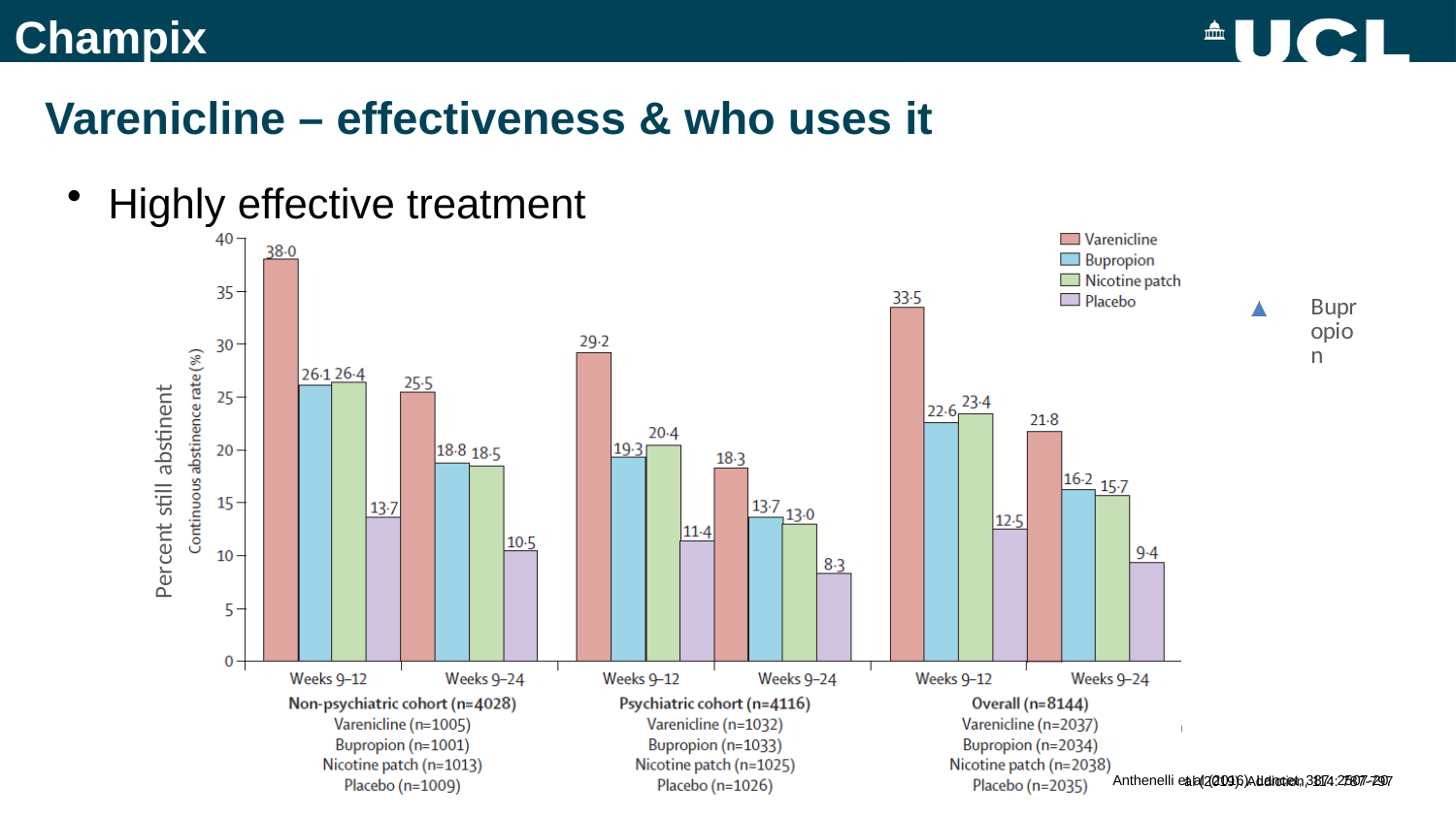
Which treatment has the lowest continuous abstinence rate at Weeks 9–12 in the Psychiatric cohort? Placebo What is the continuous abstinence rate for Placebo at Weeks 9–24 in the Psychiatric cohort? 8.3 Which treatment has the highest continuous abstinence rate at Weeks 9–24 in the Overall group? Varenicline What is the difference between the Varenicline rates at Weeks 9–12 and Weeks 9–24 in the Overall group? 11.7 What is the continuous abstinence rate for Varenicline at Weeks 9–12 in the Non-psychiatric cohort? 38.0 What is the continuous abstinence rate for Nicotine patch at Weeks 9–12 in the Overall group? 23.4 At Weeks 9–12 in the Psychiatric cohort, which is larger: the Bupropion rate or the Nicotine patch rate? Nicotine patch How many series does the legend list? 4 What kind of chart is shown on the slide? Bar chart Is the Varenicline rate at Weeks 9–12 in the Overall group greater or less than 30? greater What is the difference between the Varenicline and Placebo rates at Weeks 9–12 in the Non-psychiatric cohort? 24.3 What is the label of the y-axis of the chart? Continuous abstinence rate (%)